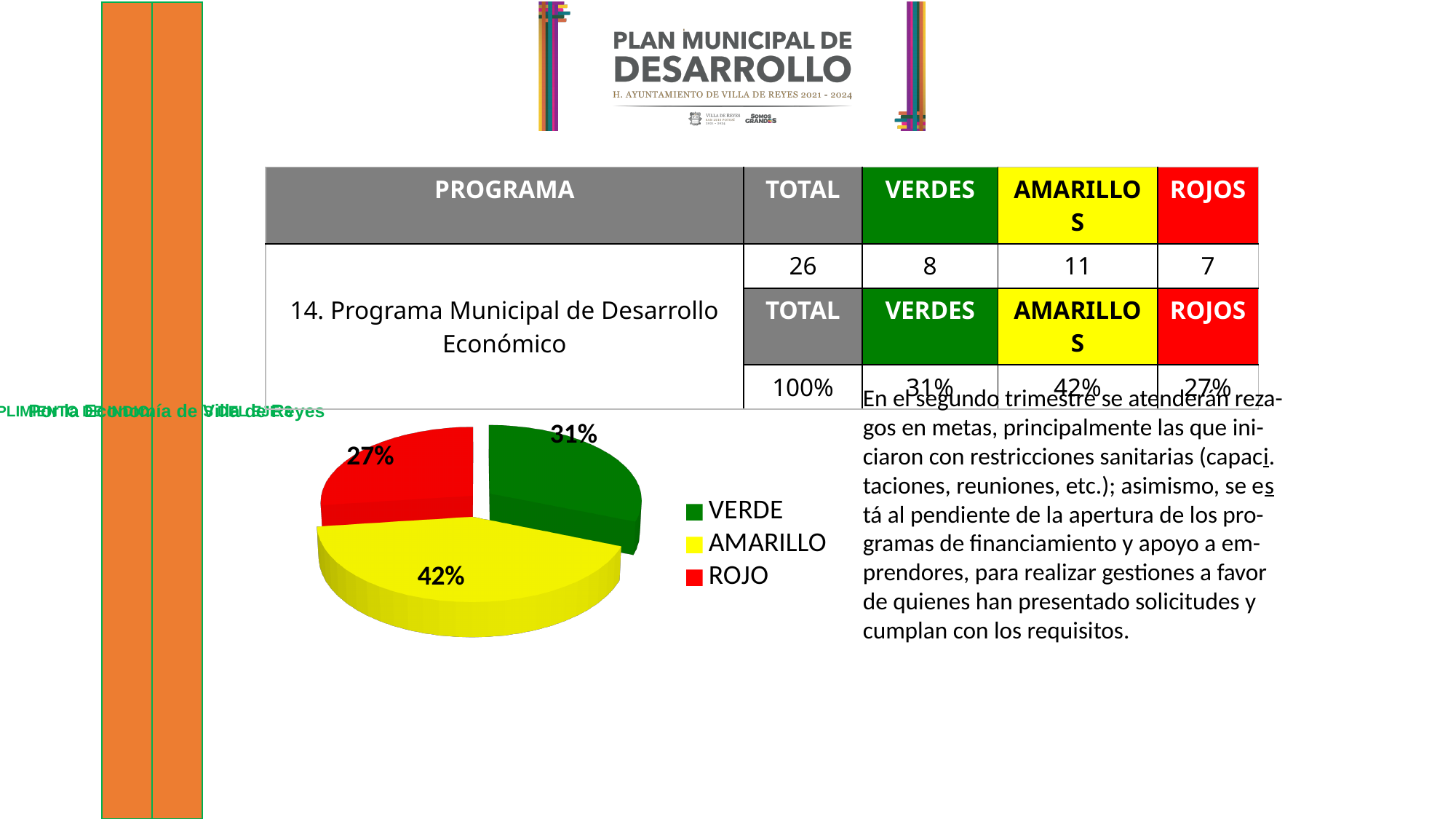
What kind of chart is shown on the slide? pie chart Which is larger in the pie chart, the VERDE slice or the ROJO slice? VERDE What share of the pie does the AMARILLO slice represent? 42% What colour is the AMARILLO slice in the pie chart? yellow Which slice of the pie chart is the smallest? ROJO What is the difference in percentage points between the AMARILLO and VERDE slices? 11% How many entries does the legend of the pie chart list? 3 What is the difference in percentage points between the VERDE and ROJO slices? 4% How many slices does the pie chart have? 3 What share of the pie does the VERDE slice represent? 31% What share of the pie does the ROJO slice represent? 27% Which slice of the pie chart is the largest? AMARILLO